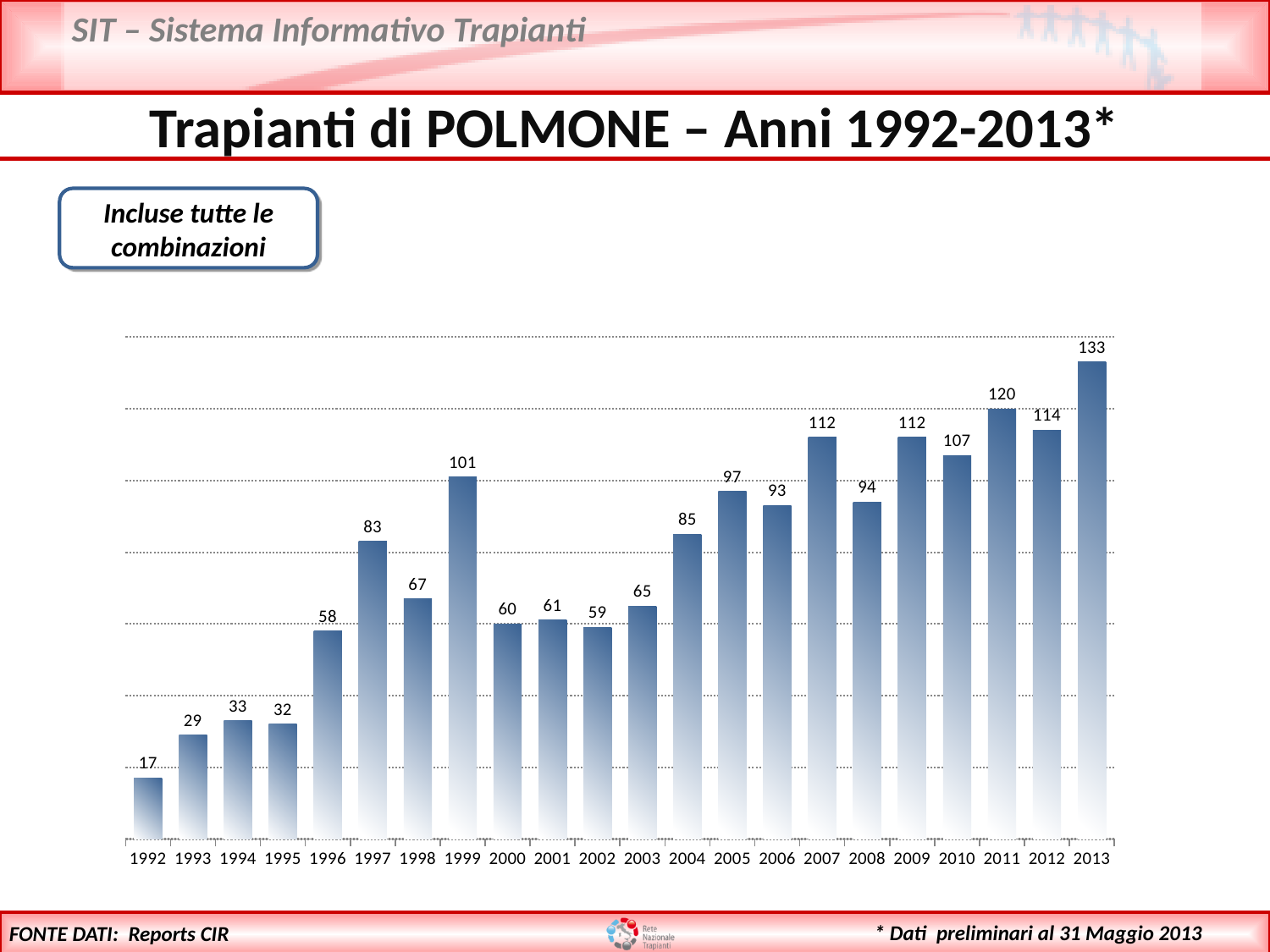
What is the value for 1999? 101 Do the values generally rise or fall from 1992 to 2013? rise What kind of chart is shown on the slide? bar chart Which year has the highest value? 2013 Which is larger, the value for 2005 or the value for 2006? 2005 What is the value for 2008? 94 How many years are shown on the x axis? 22 What is the title of the slide's chart? Trapianti di POLMONE – Anni 1992-2013* What is the difference between the values for 2013 and 2012? 19 What is the value for 1992? 17 What is the difference between the values for 1997 and 1996? 25 Which year has the lowest value? 1992